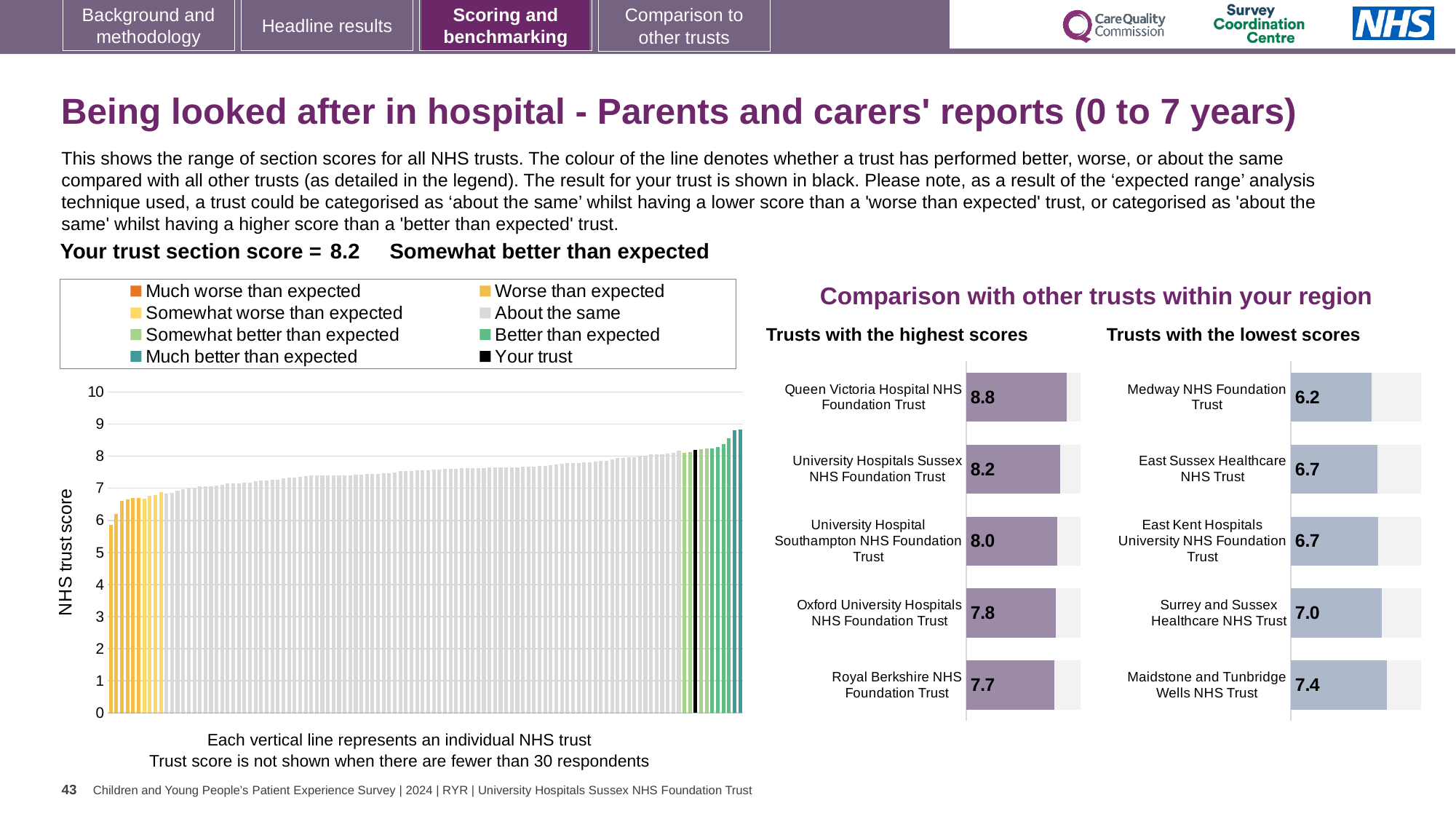
How many entries does the legend of the main 'NHS trust score' chart list? 8 In the 'Trusts with the highest scores' chart, what is the score for Queen Victoria Hospital NHS Foundation Trust? 8.8 In the 'Trusts with the highest scores' chart, which trust has the lowest score shown? Royal Berkshire NHS Foundation Trust In the main 'NHS trust score' chart on the left, do the trust scores rise or fall from left to right? rise In the 'Trusts with the lowest scores' chart, what is the score for Medway NHS Foundation Trust? 6.2 What kind of chart is the 'Trusts with the highest scores' chart? bar chart In the 'Trusts with the highest scores' chart, what is the difference between the scores of Queen Victoria Hospital NHS Foundation Trust and Royal Berkshire NHS Foundation Trust? 1.1 In the 'Trusts with the lowest scores' chart, which trust has the highest score shown? Maidstone and Tunbridge Wells NHS Trust How many trusts are listed in the 'Trusts with the highest scores' chart? 5 In the 'Trusts with the lowest scores' chart, what is the score for Surrey and Sussex Healthcare NHS Trust? 7.0 In the 'Trusts with the lowest scores' chart, which has the larger score: Surrey and Sussex Healthcare NHS Trust or Medway NHS Foundation Trust? Surrey and Sussex Healthcare NHS Trust In the main 'NHS trust score' chart on the left, what is the section score for your trust? 8.2